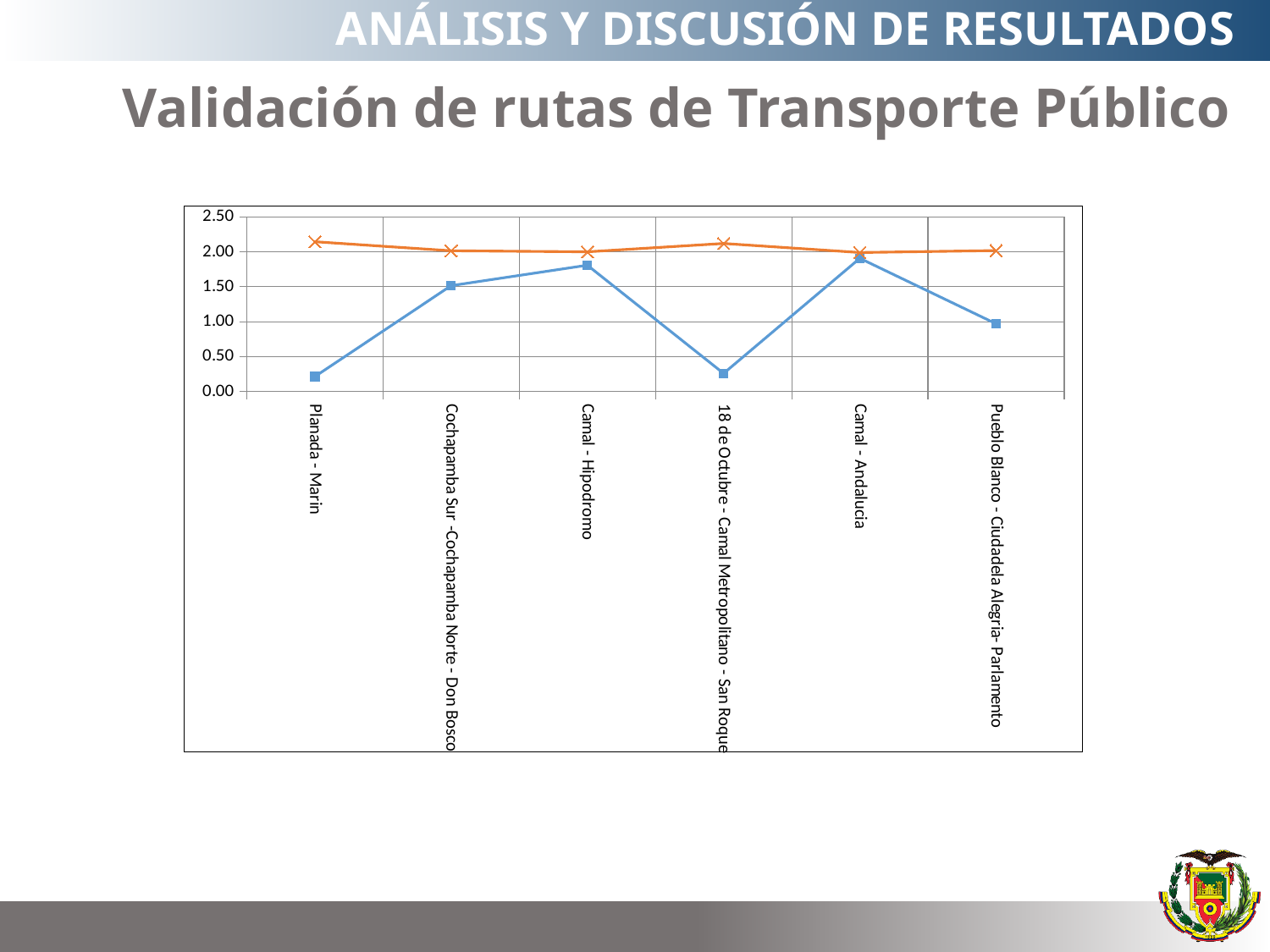
Does the blue series rise or fall from Planada - Marin to Camal - Hipodromo? Rise Is the value of the blue series for Camal - Hipodromo greater or less than 1.50? greater Is the value of the blue series for Pueblo Blanco - Ciudadela Alegria - Parlamento greater or less than 1.50? less For the blue series, which is larger: the value for Camal - Hipodromo or the value for Planada - Marin? Camal - Hipodromo Is the value of the blue series for Planada - Marin greater or less than 0.50? less What is the title shown above the chart on the slide? Validación de rutas de Transporte Público How many route categories are plotted along the x axis? 6 What kind of chart is shown on the slide? Line chart At Planada - Marin, which series has the larger value: the orange series or the blue series? The orange series